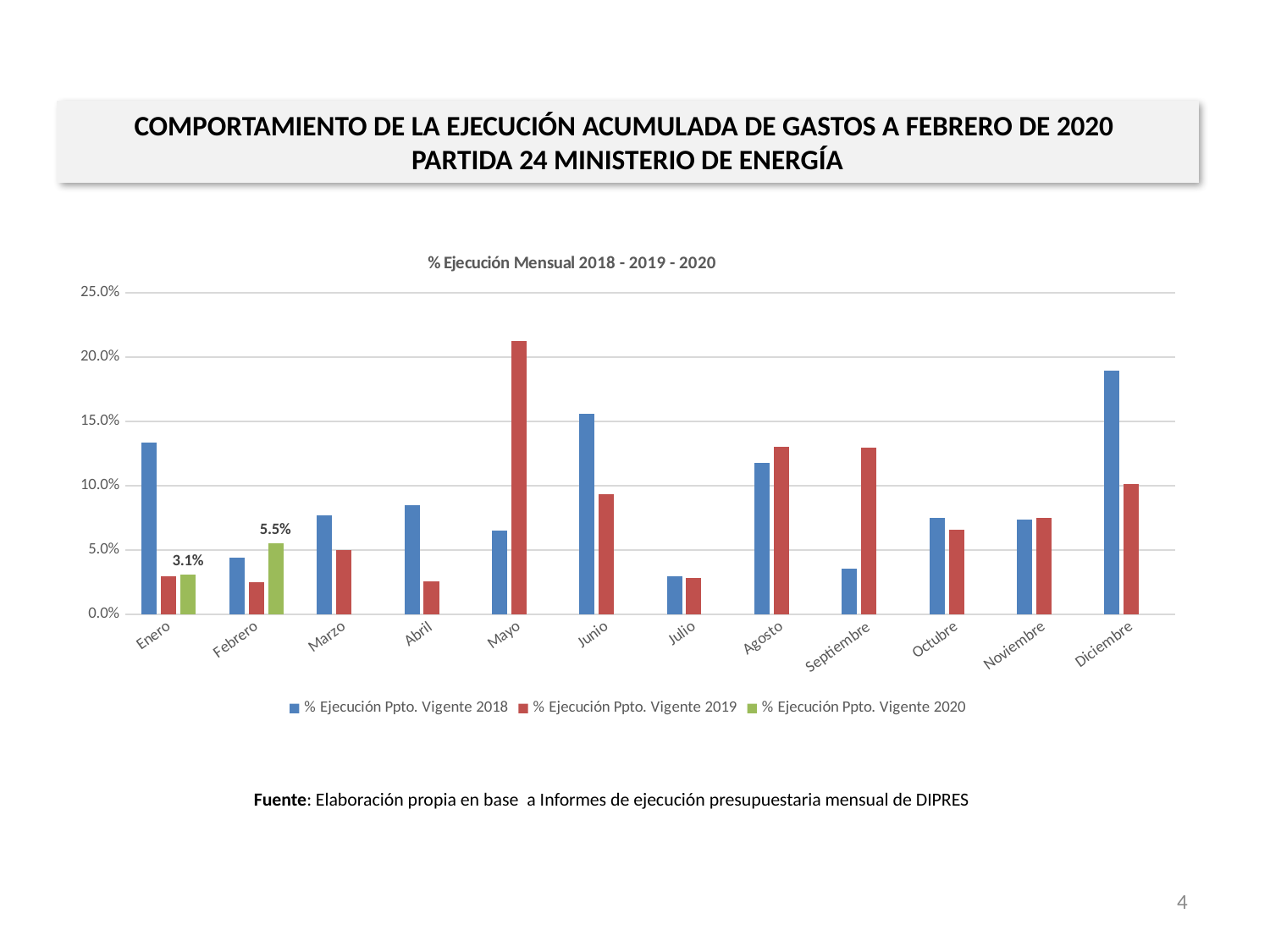
How many months are shown on the x axis of the chart? 12 Is the 2019 value for Agosto greater or less than 10.0%? greater By how much does the 2020 value for Febrero exceed the 2020 value for Enero? 2.4% What is the % Ejecución Ppto. Vigente 2020 value for Enero? 3.1% For Junio, which series has the larger value: 2018 or 2019? 2018 In which month is the % Ejecución Ppto. Vigente 2018 value highest? Diciembre Is the 2018 value for Diciembre greater or less than 15.0%? greater For Septiembre, which series has the larger value: 2018 or 2019? 2019 Is the 2019 value for Mayo greater or less than 20.0%? greater In which month is the % Ejecución Ppto. Vigente 2019 value highest? Mayo What is the % Ejecución Ppto. Vigente 2020 value for Febrero? 5.5% How many series does the legend list? 3